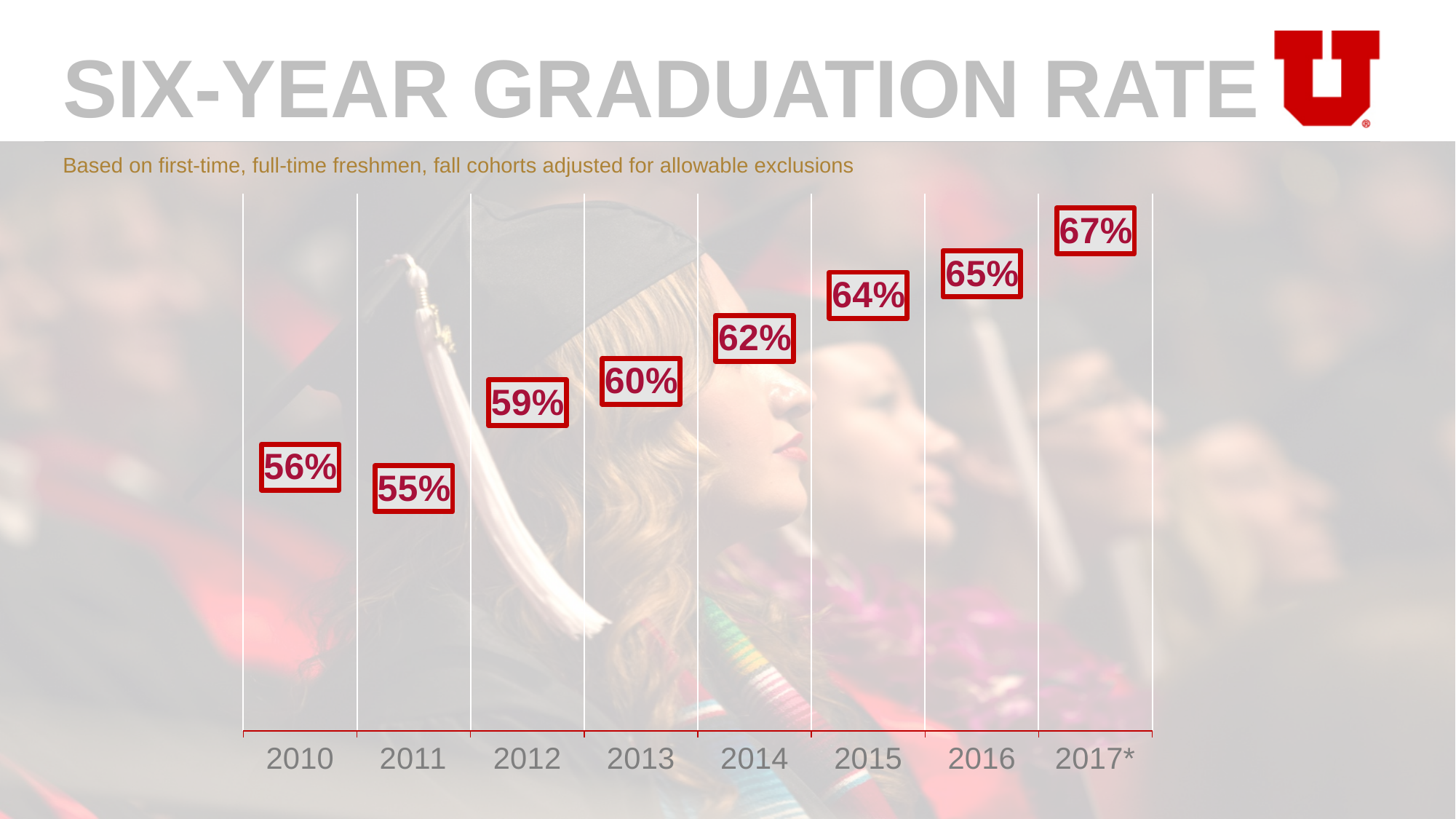
Which year has the lowest six-year graduation rate? 2011 What is the six-year graduation rate for 2017*? 67% What is the difference between the graduation rate in 2017* and in 2010? 11% Does the six-year graduation rate generally rise or fall from 2011 to 2017*? rise What is the six-year graduation rate for 2011? 55% Which year has a higher graduation rate, 2010 or 2011? 2010 How many years are shown on the x axis of the chart? 8 What is the six-year graduation rate for 2015? 64% What is the difference between the graduation rate in 2014 and in 2012? 3% Which year has the highest six-year graduation rate? 2017* What is the title of the slide containing the chart? SIX-YEAR GRADUATION RATE What is the six-year graduation rate for 2013? 60%